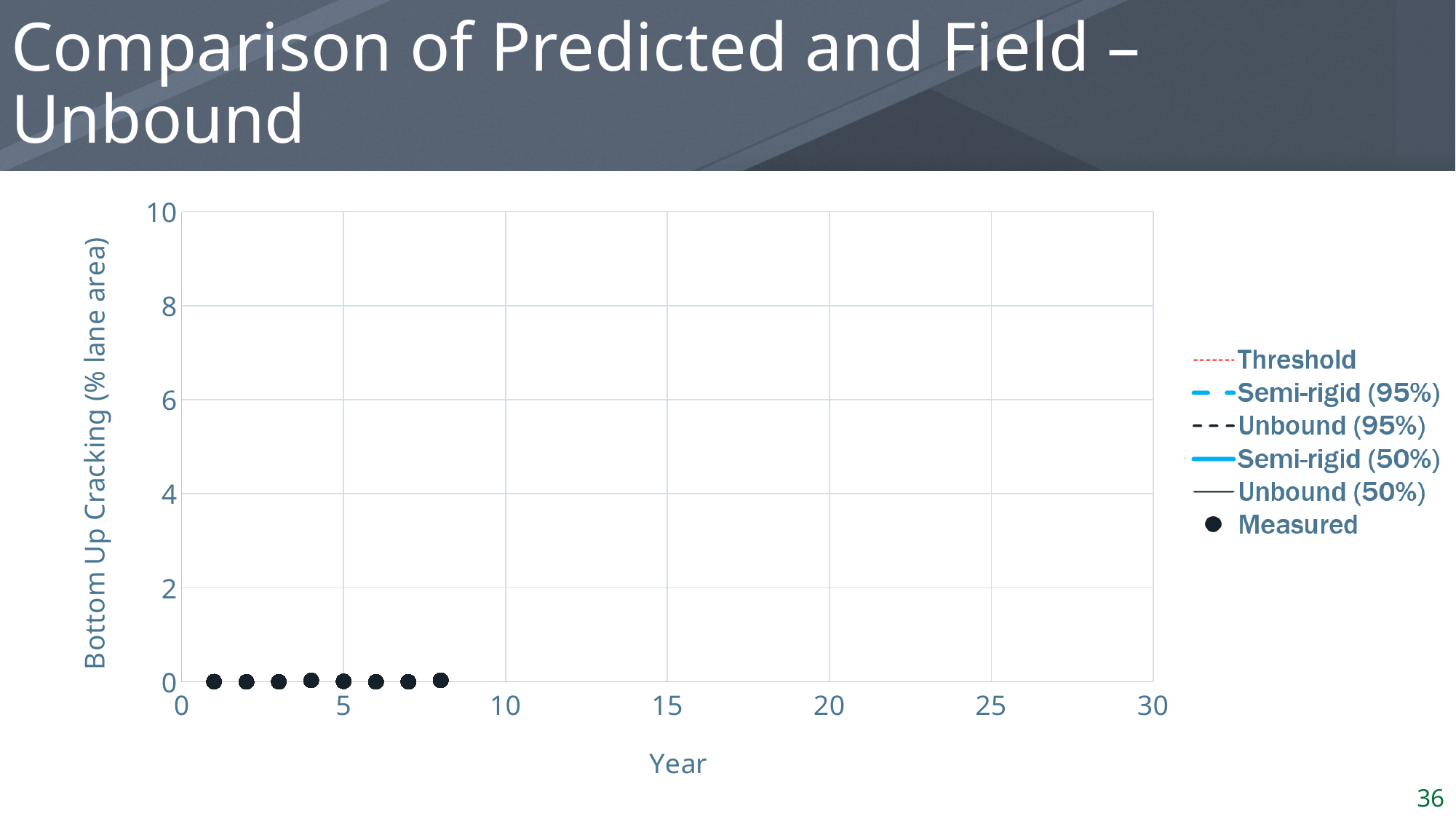
Which legend series is plotted with dots rather than a line? Measured Is the Measured value at year 3 greater or less than 2? less How many Measured data points are plotted on the chart? 8 What is the label of the y axis? Bottom Up Cracking (% lane area) What kind of chart is shown on the slide? Scatter chart What is the maximum value shown on the y axis? 10 What is the label of the x axis? Year Do the Measured values rise, fall, or stay flat from year 1 to year 8? Stay flat What is the maximum value shown on the x axis? 30 How many series does the legend list? 6